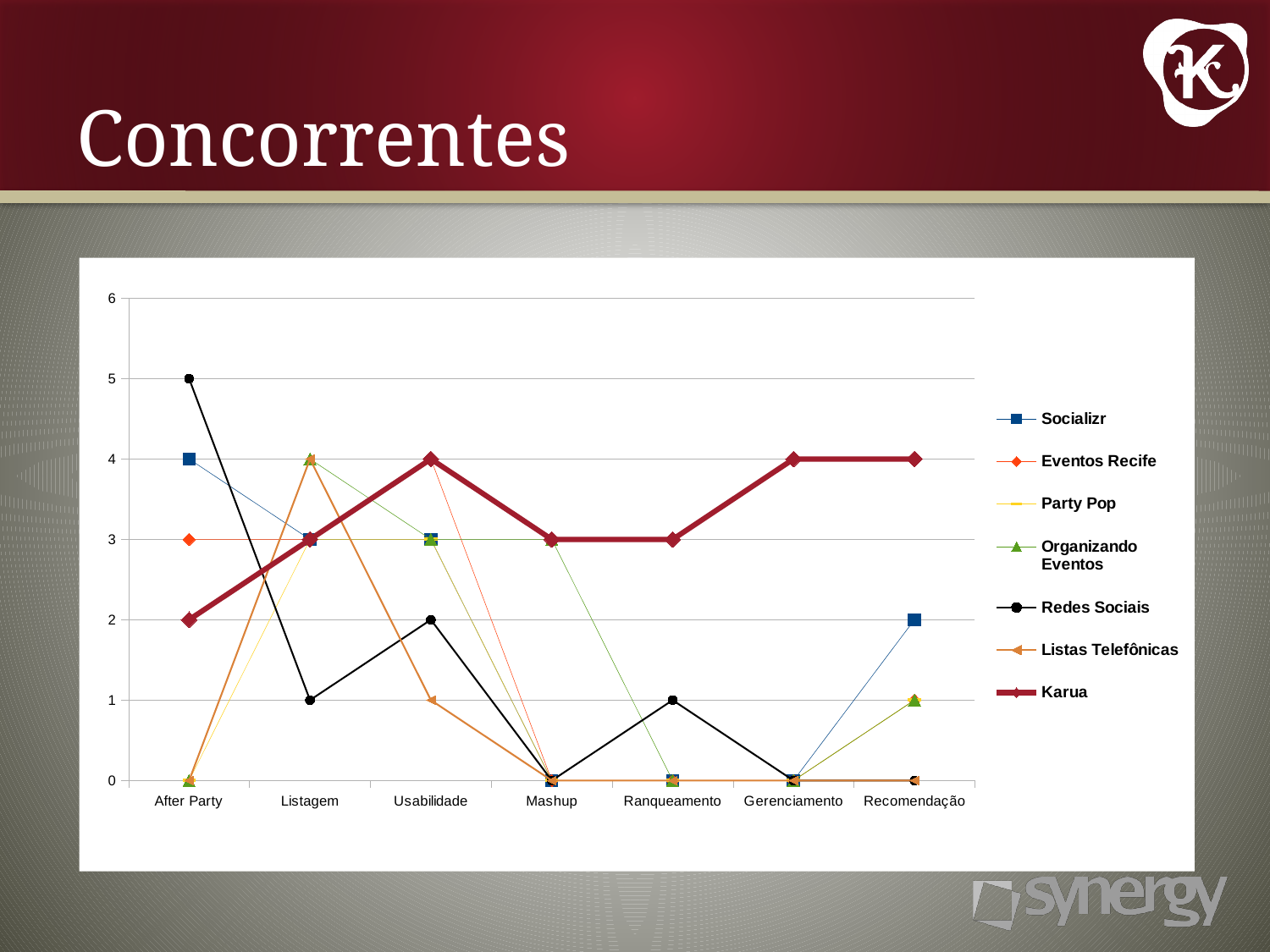
What is the difference between Redes Sociais and Karua at After Party? 3 What is the value for Karua at Usabilidade? 4 How many series does the legend list? 7 Which series has the highest value at After Party? Redes Sociais How many categories are shown on the x axis? 7 What is the title of the slide? Concorrentes What is the value for Karua at After Party? 2 What is the value for Socializr at Recomendação? 2 What is the value for Redes Sociais at After Party? 5 Which series has the highest value at Gerenciamento? Karua Which is larger at Recomendação, Socializr or Organizando Eventos? Socializr What kind of chart is shown on the slide? line chart